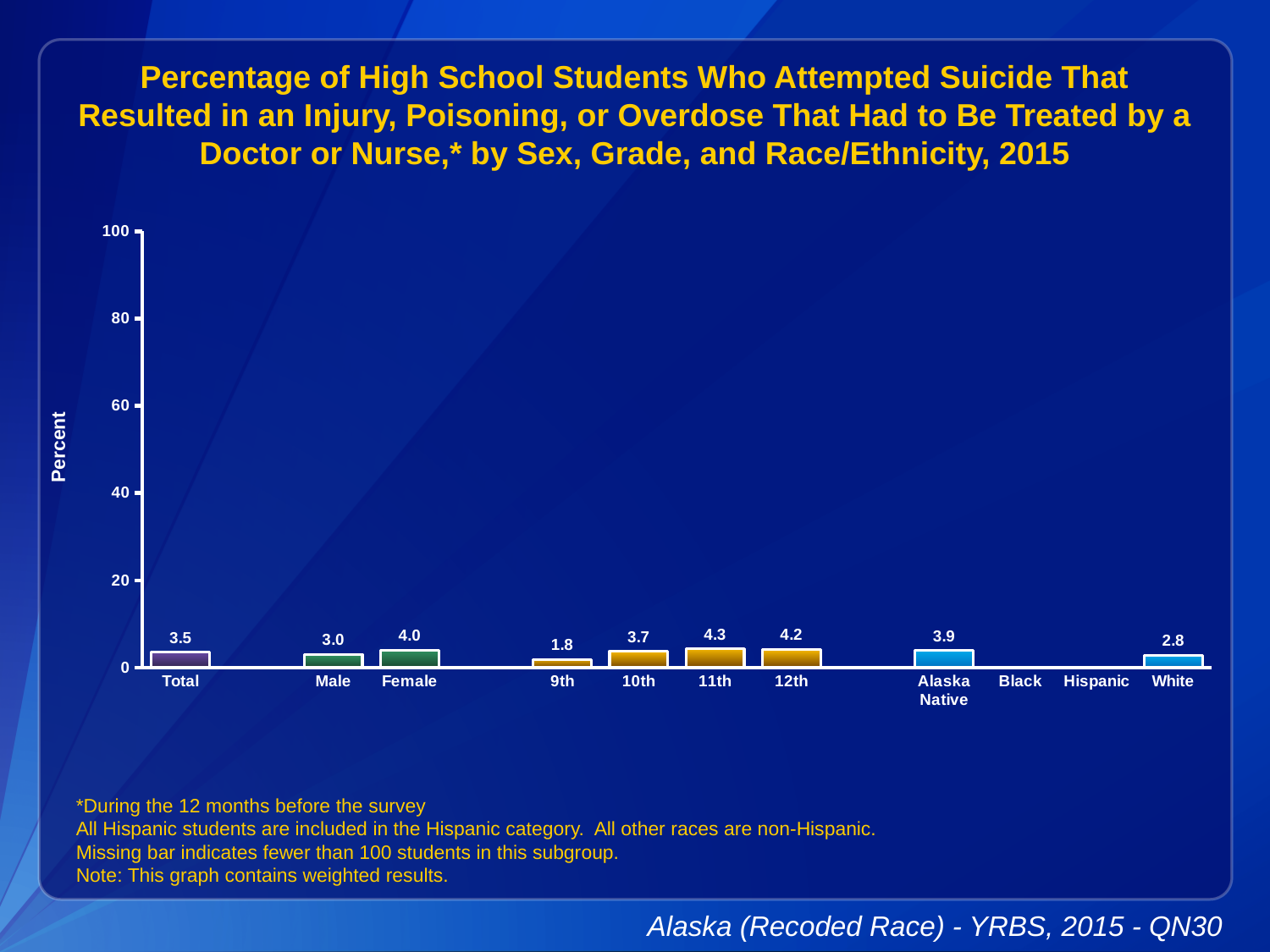
What is the label of the y axis? Percent What is the value for 9th grade? 1.8 What is the value for Female? 4.0 Which is larger, the value for 10th grade or the value for White? 10th How many categories are labelled on the x axis? 11 What kind of chart is shown? bar chart What is the value for Alaska Native? 3.9 What is the difference between the Female and Male values? 1.0 Is the value for 12th grade greater or less than 20? less What is the value for Total? 3.5 Which category has the highest value? 11th Which category with a bar has the lowest value? 9th